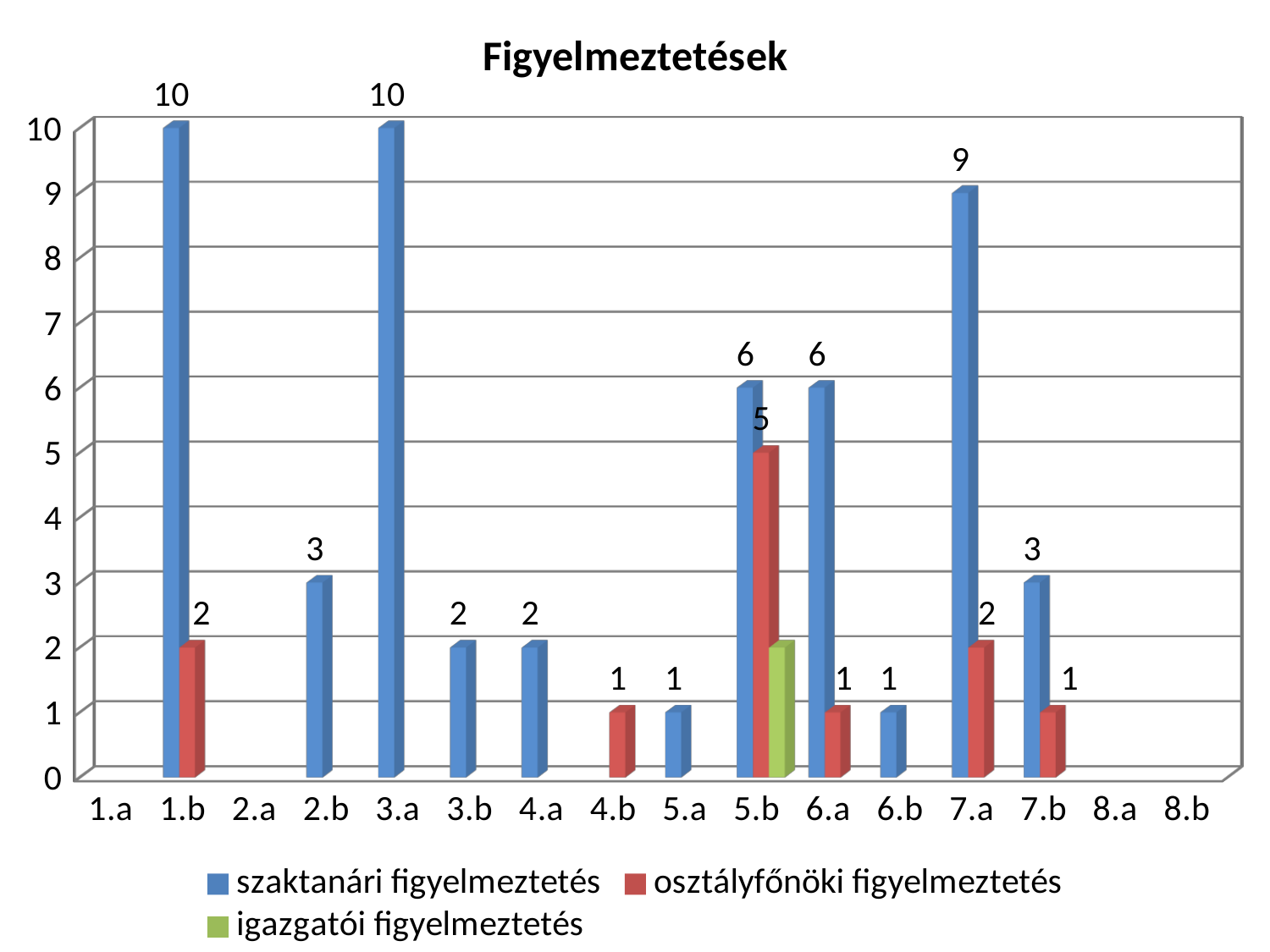
How many categories are shown on the x axis? 16 Is the igazgatói figyelmeztetés value for 5.b greater or less than 3? less What kind of chart is shown on the slide? bar chart What is the value of osztályfőnöki figyelmeztetés for 1.b? 2 What is the title of the chart? Figyelmeztetések What is the value of szaktanári figyelmeztetés for 6.a? 6 What is the value of osztályfőnöki figyelmeztetés for 5.b? 5 How many series does the legend list? 3 Which category has the highest osztályfőnöki figyelmeztetés value? 5.b Which has the larger szaktanári figyelmeztetés value, 2.b or 3.b? 2.b What is the difference between szaktanári figyelmeztetés and osztályfőnöki figyelmeztetés for 5.b? 1 What is the value of szaktanári figyelmeztetés for 7.a? 9